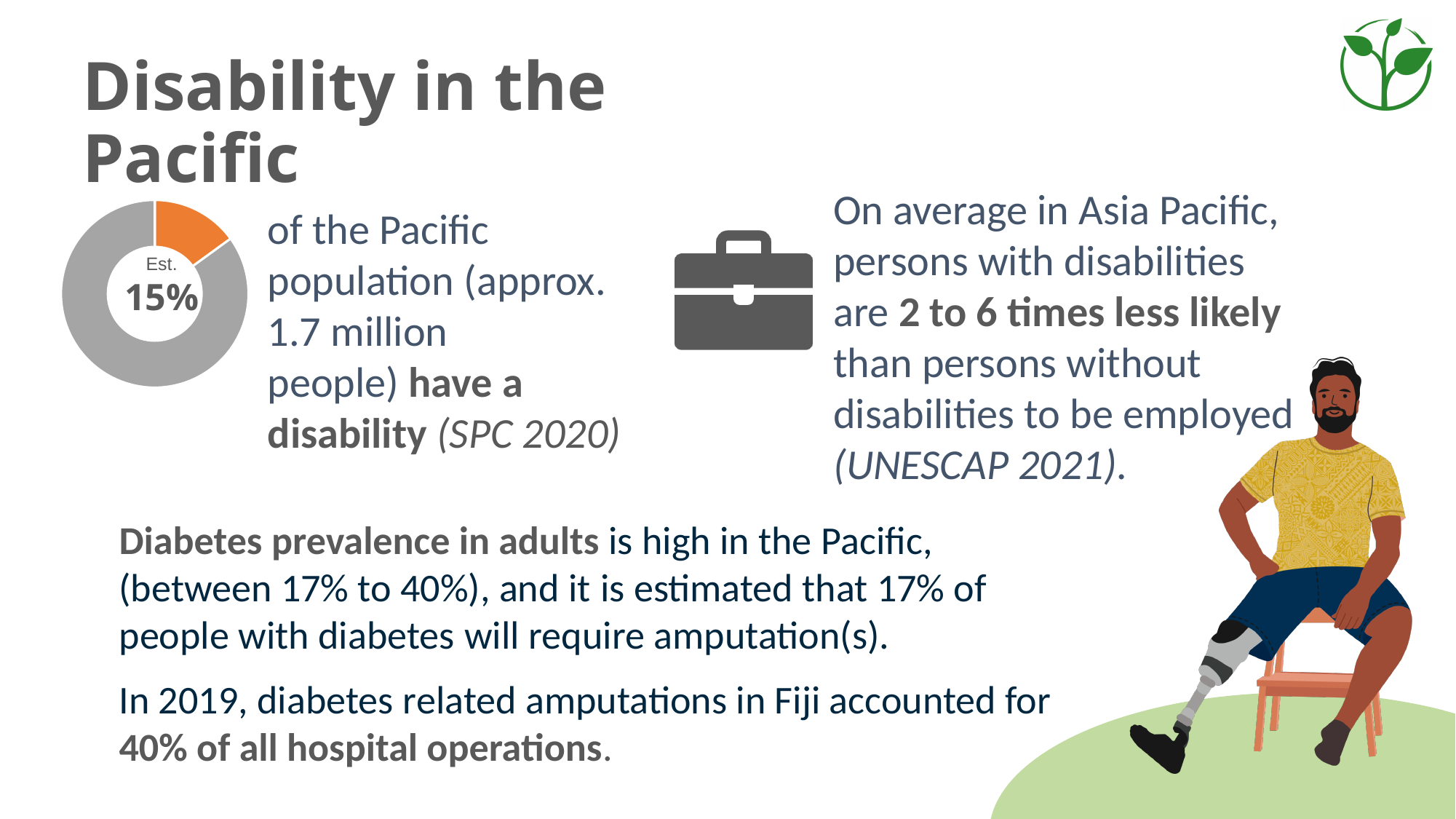
According to the text beside the donut chart, approximately how many people does the 15% represent? 1.7 million people What colour is the slice of the donut chart that represents the 15% of the Pacific population with a disability? Orange What value is printed in the centre of the donut chart? Est. 15% How many slices does the donut chart have? 2 Is the share shown by the orange slice of the donut chart greater or less than 50%? less Which slice of the donut chart is larger, the orange slice or the grey slice? The grey slice What share of the Pacific population does the orange slice of the donut chart represent? 15% What kind of chart is shown on the left of the slide next to the text about the Pacific population? Donut chart